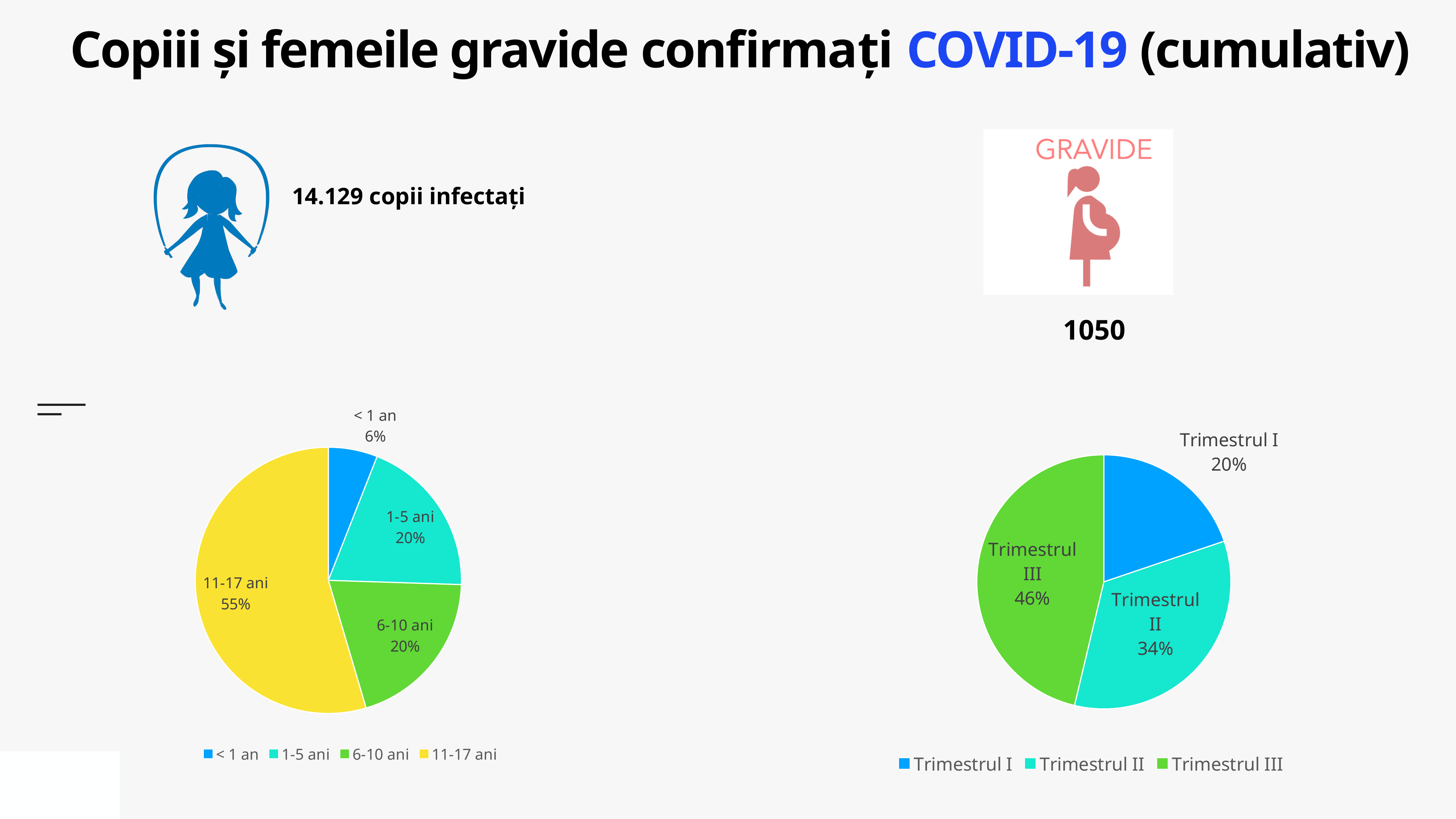
In the right pie chart (pregnant women by trimester), what share is shown for Trimestrul II? 34% In the left pie chart (children by age group), what share is shown for the 11-17 ani slice? 55% In the right pie chart (pregnant women by trimester), which trimester has the smallest share? Trimestrul I What type of chart is the chart on the right of the slide? Pie chart In the left pie chart (children by age group), how many slices does the pie have? 4 In the left pie chart (children by age group), which age group has the largest share? 11-17 ani In the right pie chart (pregnant women by trimester), how many entries does the legend list? 3 In the right pie chart (pregnant women by trimester), which trimester has the largest share? Trimestrul III In the right pie chart (pregnant women by trimester), which is larger: Trimestrul II or Trimestrul I? Trimestrul II In the left pie chart (children by age group), what is the difference between the 11-17 ani share and the 1-5 ani share? 35 percentage points In the left pie chart (children by age group), what share is shown for the < 1 an slice? 6% In the left pie chart (children by age group), which age group has the smallest share? < 1 an